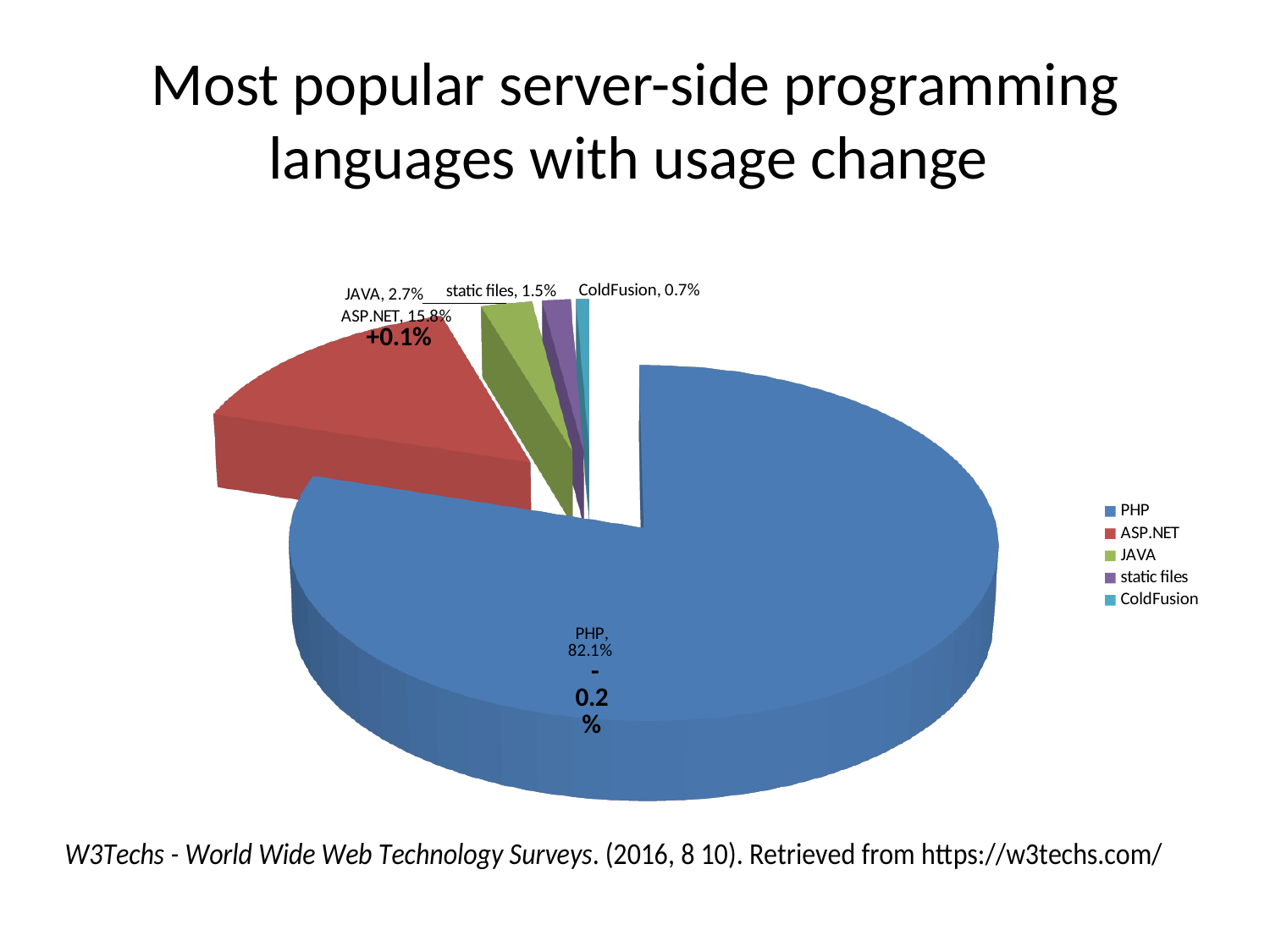
How many categories does the legend list? 5 Which category has the smallest slice of the pie? ColdFusion What usage change is annotated on the PHP slice? -0.2% What is the value shown for JAVA? 2.7% What is the value shown for ASP.NET? 15.8% What kind of chart is shown on the slide? pie chart Which language has the largest slice of the pie? PHP What is the value shown for static files? 1.5% What is the difference between the PHP and ASP.NET shares? 66.3% Which is larger, the share for JAVA or the share for static files? JAVA What is the value shown for ColdFusion? 0.7% What share of the pie does PHP have? 82.1%